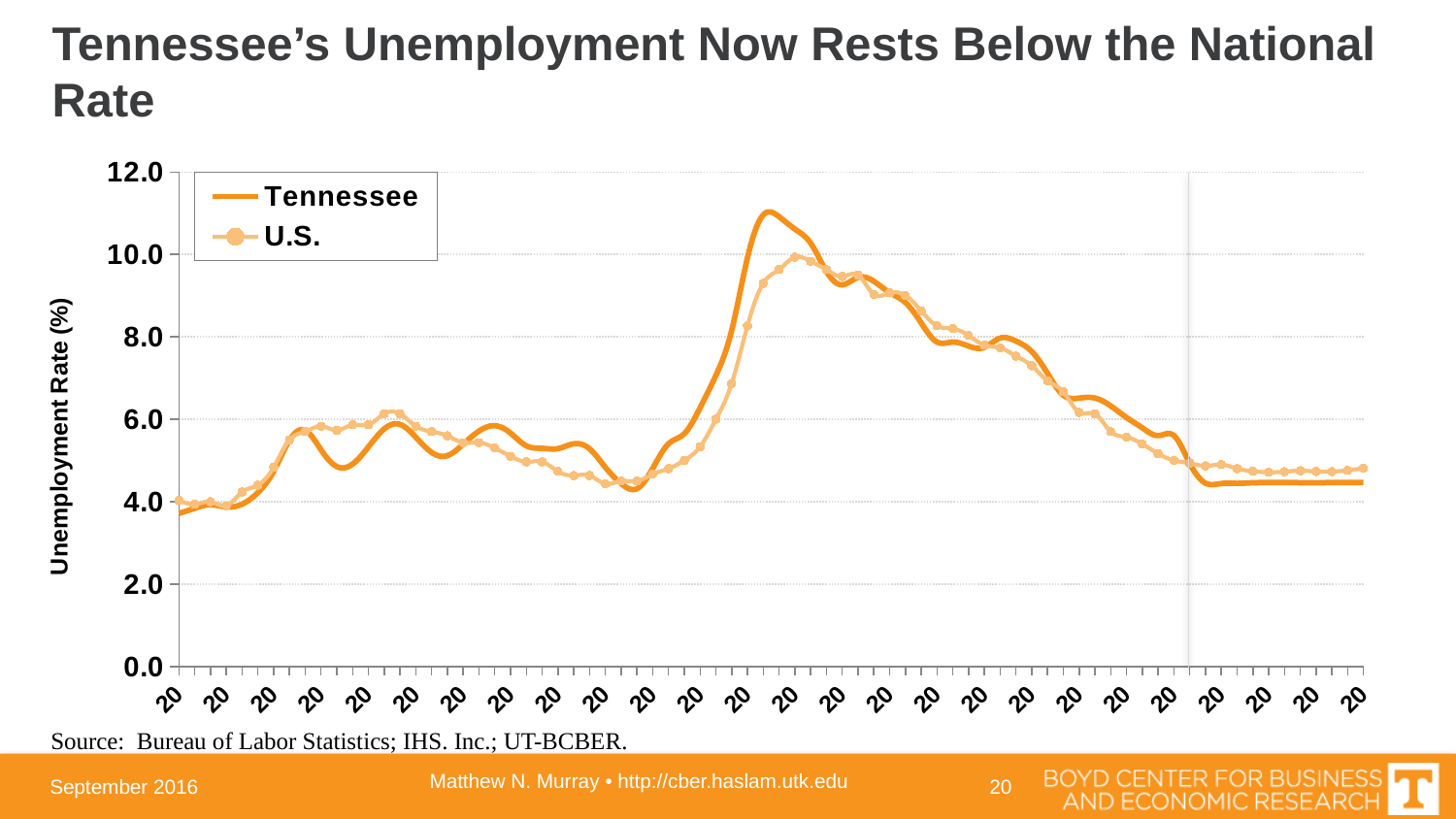
What are the two series named in the chart's legend? Tennessee and U.S. How many series does the chart's legend list? 2 Which series reaches the higher peak value, Tennessee or U.S.? Tennessee Is the value of the Tennessee line at the right end of the chart greater or less than 6.0? less At the right end of the chart, which line is higher, Tennessee or U.S.? U.S. What kind of chart is shown on the slide? line chart After reaching their peaks, do the Tennessee and U.S. lines rise or fall toward the right end of the chart? fall Is the peak value of the Tennessee line greater or less than 10.0? greater What is the label on the chart's vertical axis? Unemployment Rate (%) Is the peak value of the U.S. line greater or less than 8.0? greater What is the highest value shown on the chart's vertical axis? 12.0